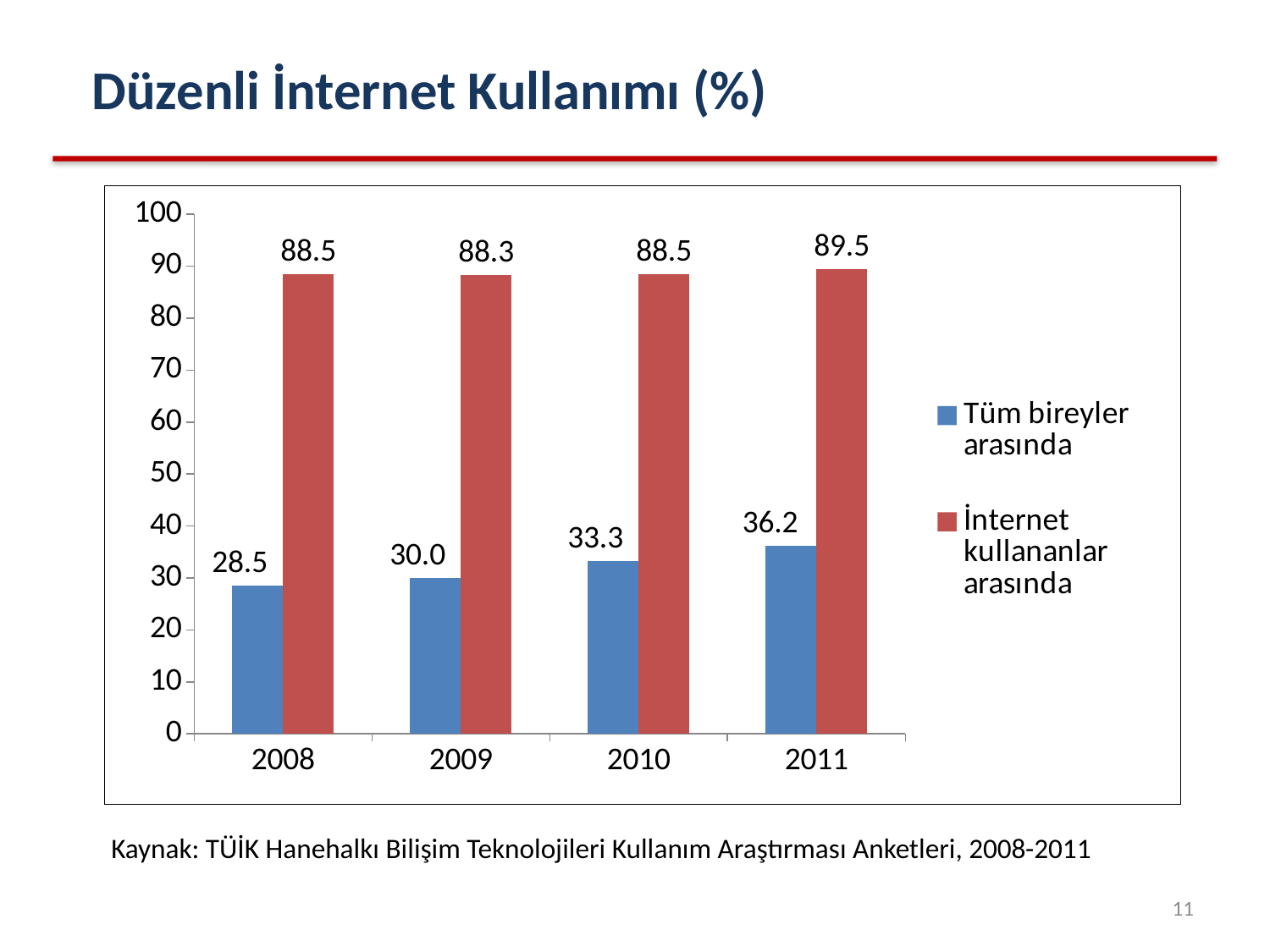
What is the difference between the 'Tüm bireyler arasında' values in 2011 and 2008? 7.7 What is the difference between the 'İnternet kullananlar arasında' and 'Tüm bireyler arasında' values in 2011? 53.3 In which year is the 'Tüm bireyler arasında' value highest? 2011 What kind of chart is shown on the slide? Bar chart What is the value for 'Tüm bireyler arasında' in 2008? 28.5 Do the 'Tüm bireyler arasında' values rise or fall from 2008 to 2011? Rise How many years are shown on the x axis? 4 How many series does the legend list? 2 Which is larger: the 'Tüm bireyler arasında' value in 2009 or in 2010? 2010 What is the value for 'Tüm bireyler arasında' in 2010? 33.3 In which year is the 'Tüm bireyler arasında' value lowest? 2008 What is the value for 'İnternet kullananlar arasında' in 2011? 89.5